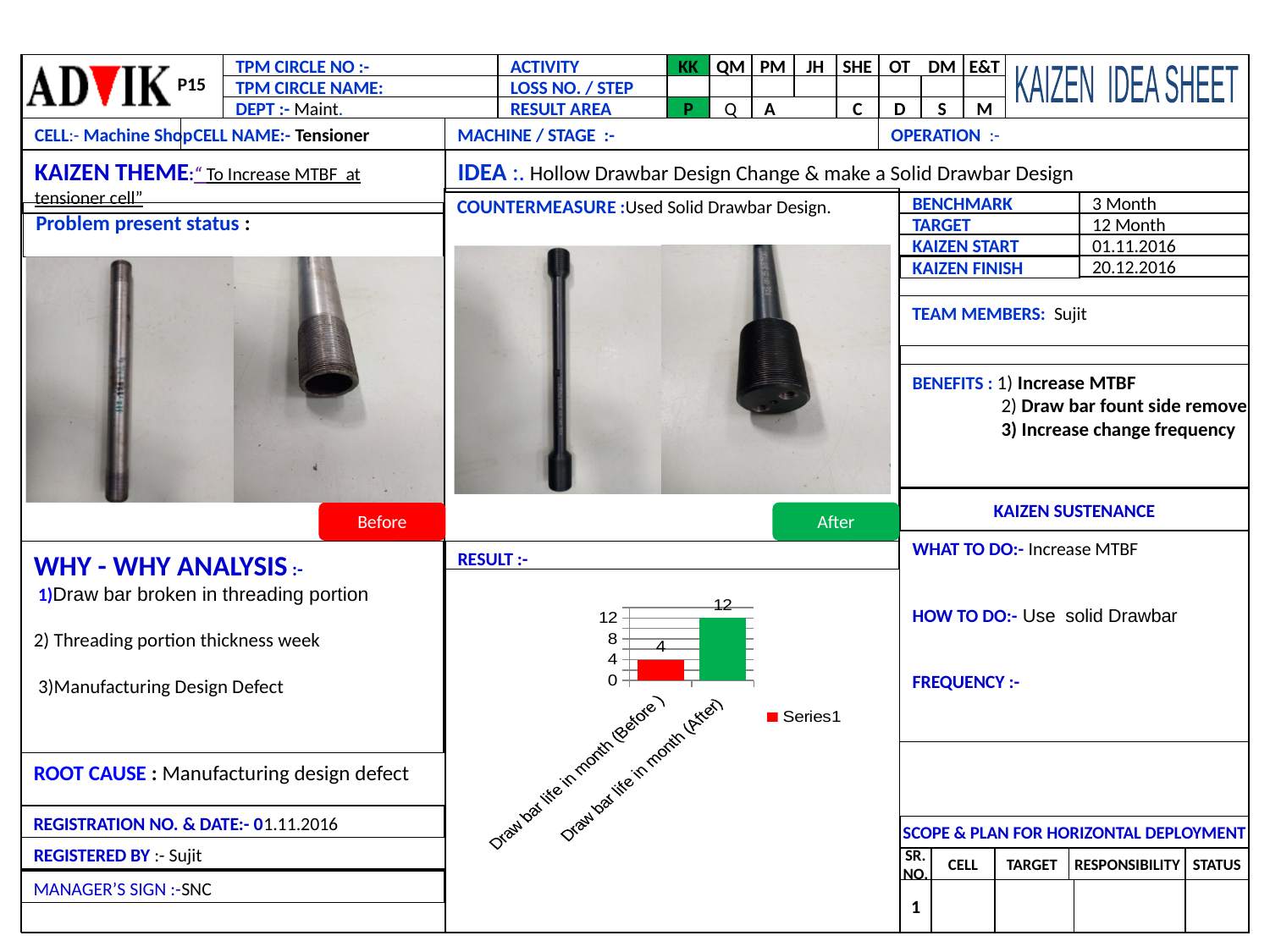
Do the values rise or fall from the Before category to the After category? rise How many categories are plotted in the chart? 2 What is the value for Draw bar life in month (Before)? 4 Which category has the lowest value in the chart? Draw bar life in month (Before ) How many series does the chart legend list? 1 What type of chart is shown in the RESULT section? bar chart Is the value for Draw bar life in month (After) greater or less than 8? greater Which is larger, the Before value or the After value? After What is the name of the series shown in the chart legend? Series1 What is the value for Draw bar life in month (After)? 12 What is the difference between the After value and the Before value? 8 Which category has the highest value in the chart? Draw bar life in month (After)